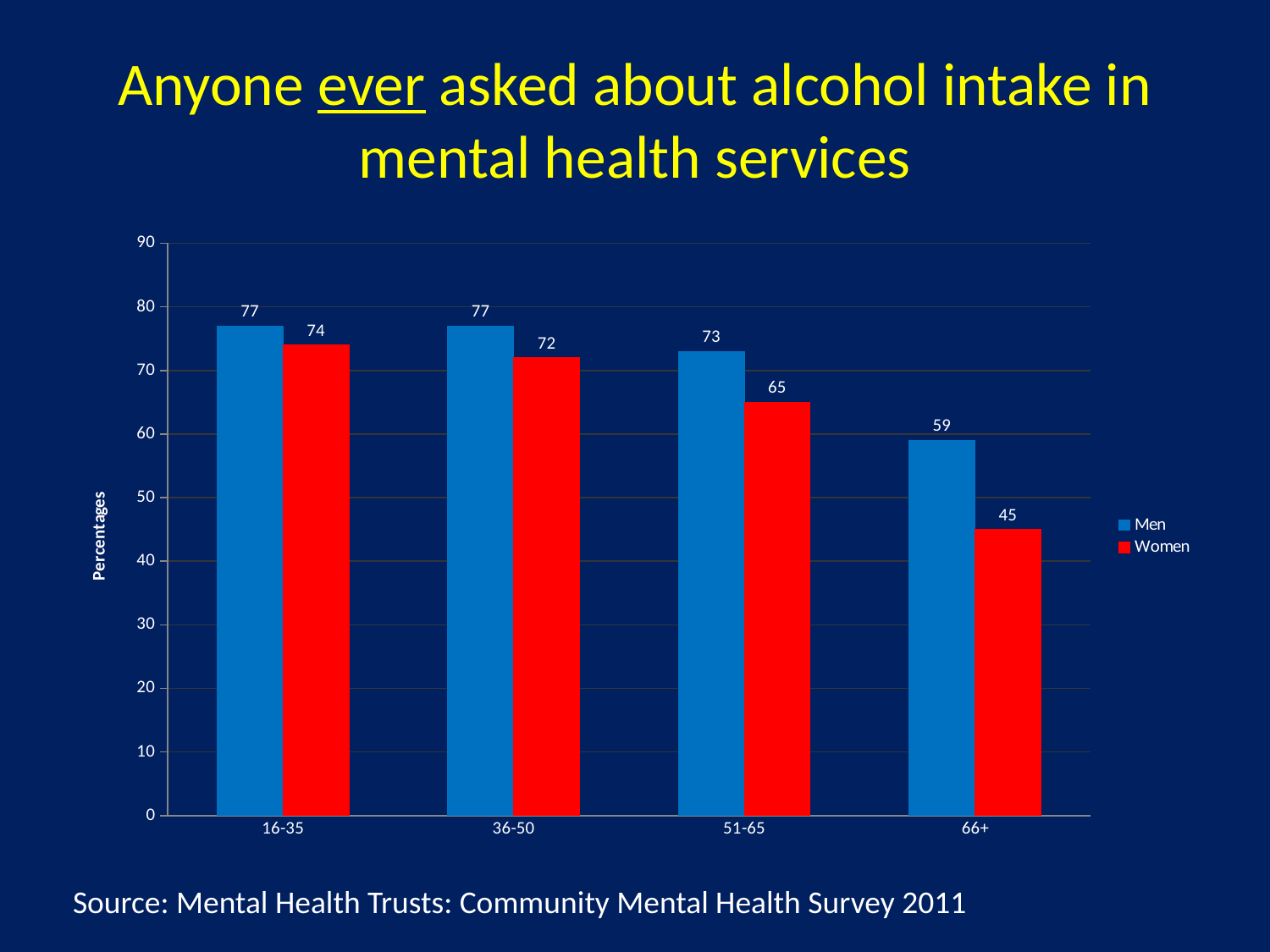
Which is larger in the 36-50 age group, Men or Women? Men What is the value for Women in the 51-65 age group? 65 Do the values for Women rise or fall across the age groups from 16-35 to 66+? Fall What is the value for Men in the 16-35 age group? 77 Which age group has the lowest value for Women? 66+ How many series does the legend list? 2 What is the value for Women in the 66+ age group? 45 How many age groups are shown on the x axis? 4 What is the difference between Men and Women in the 51-65 age group? 8 What kind of chart is shown on the slide? Bar chart Which age group has the lowest value for Men? 66+ What is the difference between Men and Women in the 66+ age group? 14